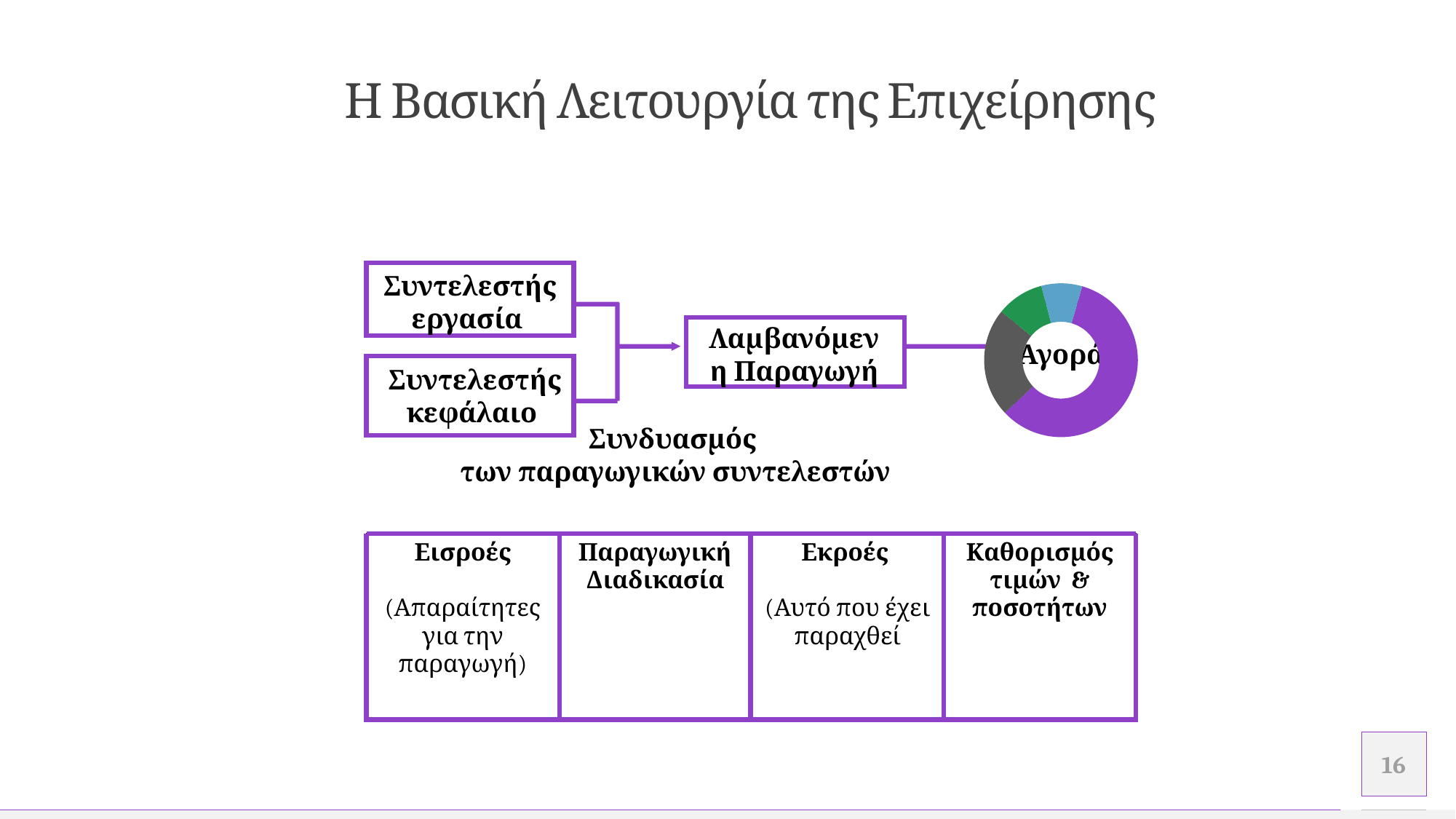
What colours are the four slices of the doughnut chart? Purple, gray, green and blue What word is written in the centre of the doughnut chart? Αγορά In the doughnut chart, which is larger, the purple slice or the gray slice? The purple slice How many slices does the doughnut chart have? 4 Which slice of the doughnut chart is the largest? The purple slice In the doughnut chart, which is larger, the gray slice or the green slice? The gray slice What kind of chart is shown next to the box labelled "Λαμβανόμενη Παραγωγή"? Doughnut chart